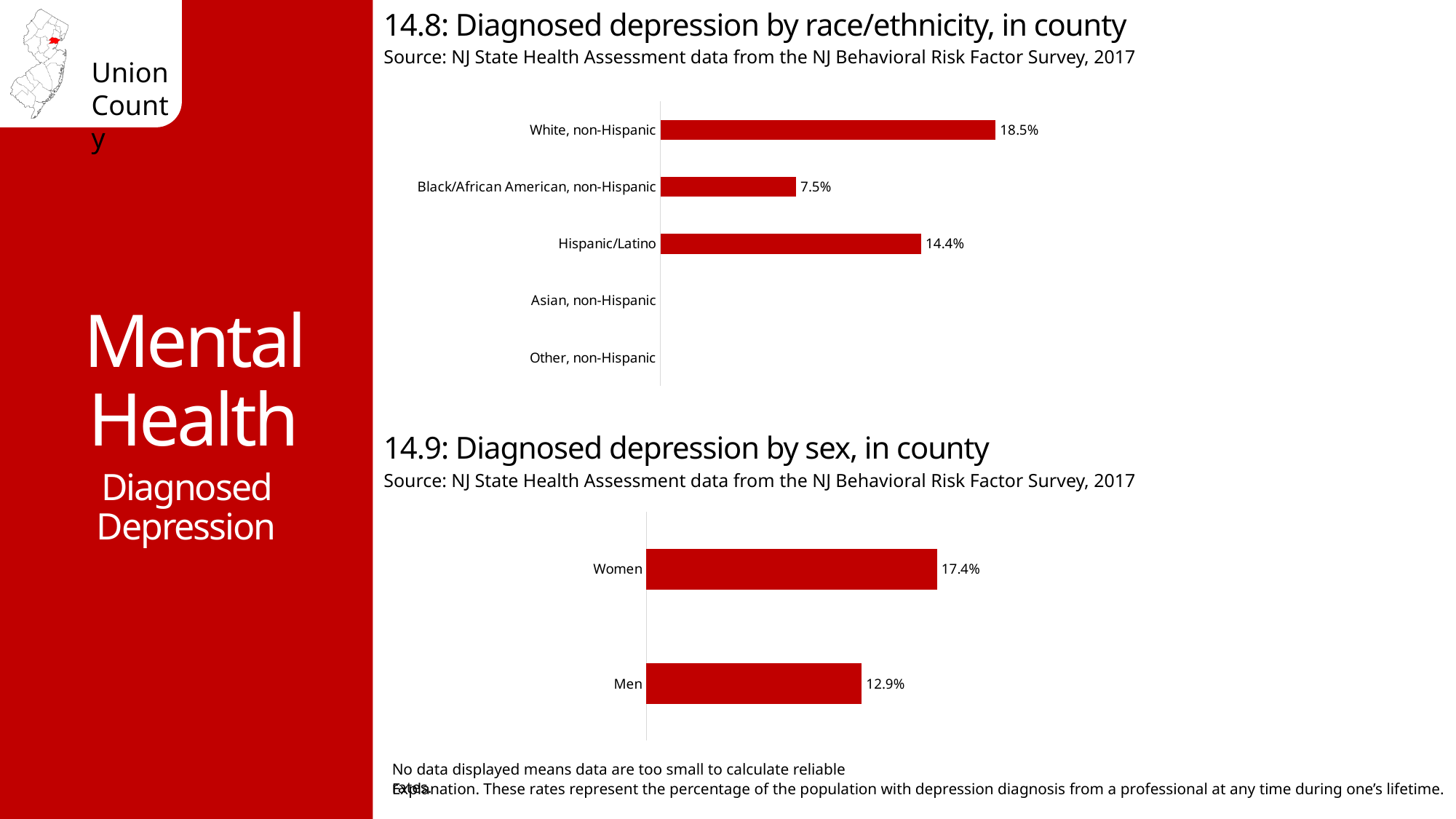
In chart 14.9 (Diagnosed depression by sex), what is the difference between the Women and Men values? 4.5% What kind of chart is chart 14.9 (Diagnosed depression by sex)? Bar chart In chart 14.9 (Diagnosed depression by sex), what is the value for Men? 12.9% In chart 14.8 (Diagnosed depression by race/ethnicity), how many categories are listed on the axis? 5 In chart 14.8 (Diagnosed depression by race/ethnicity), what is the value for Hispanic/Latino? 14.4% In chart 14.8 (Diagnosed depression by race/ethnicity), which category has the highest value? White, non-Hispanic In chart 14.9 (Diagnosed depression by sex), what is the value for Women? 17.4% In chart 14.8 (Diagnosed depression by race/ethnicity), which category with a displayed bar has the lowest value? Black/African American, non-Hispanic In chart 14.8 (Diagnosed depression by race/ethnicity), which categories have no bar displayed? Asian, non-Hispanic and Other, non-Hispanic In chart 14.8 (Diagnosed depression by race/ethnicity), what is the value for Black/African American, non-Hispanic? 7.5% In chart 14.8 (Diagnosed depression by race/ethnicity), what is the value for White, non-Hispanic? 18.5% In chart 14.8 (Diagnosed depression by race/ethnicity), what is the difference between the White, non-Hispanic and Hispanic/Latino values? 4.1%